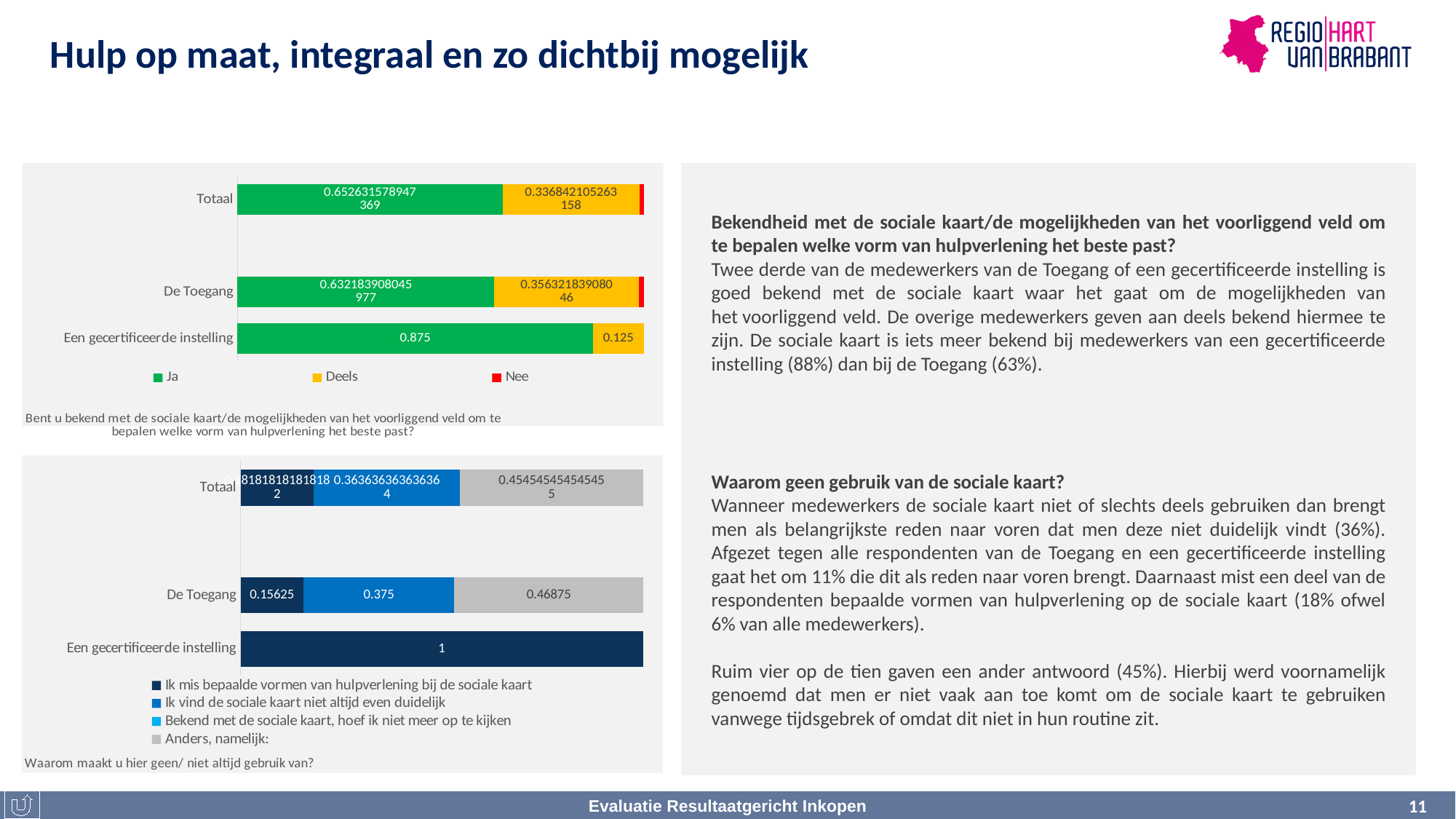
In the bottom chart, what is the difference between the 'Anders, namelijk:' value and the 'Ik mis bepaalde vormen van hulpverlening bij de sociale kaart' value for 'De Toegang'? 0.3125 In the top chart, which category has the highest 'Ja' value? Een gecertificeerde instelling What kind of chart is the top chart? Stacked bar chart In the bottom chart, what is the value for 'Ik mis bepaalde vormen van hulpverlening bij de sociale kaart' for 'De Toegang'? 0.15625 In the bottom chart, how many entries does the legend list? 4 In the top chart, how many series does the legend list? 3 In the top chart, what is the value for 'Deels' for 'Een gecertificeerde instelling'? 0.125 In the bottom chart, what is the value for 'Ik vind de sociale kaart niet altijd even duidelijk' for 'De Toegang'? 0.375 In the top chart, is the 'Ja' value for 'Totaal' larger or smaller than the 'Ja' value for 'Een gecertificeerde instelling'? smaller In the top chart, what is the value for 'Ja' for 'Een gecertificeerde instelling'? 0.875 In the bottom chart, what is the value for 'Anders, namelijk:' for 'De Toegang'? 0.46875 In the bottom chart, what is the value shown for 'Een gecertificeerde instelling'? 1